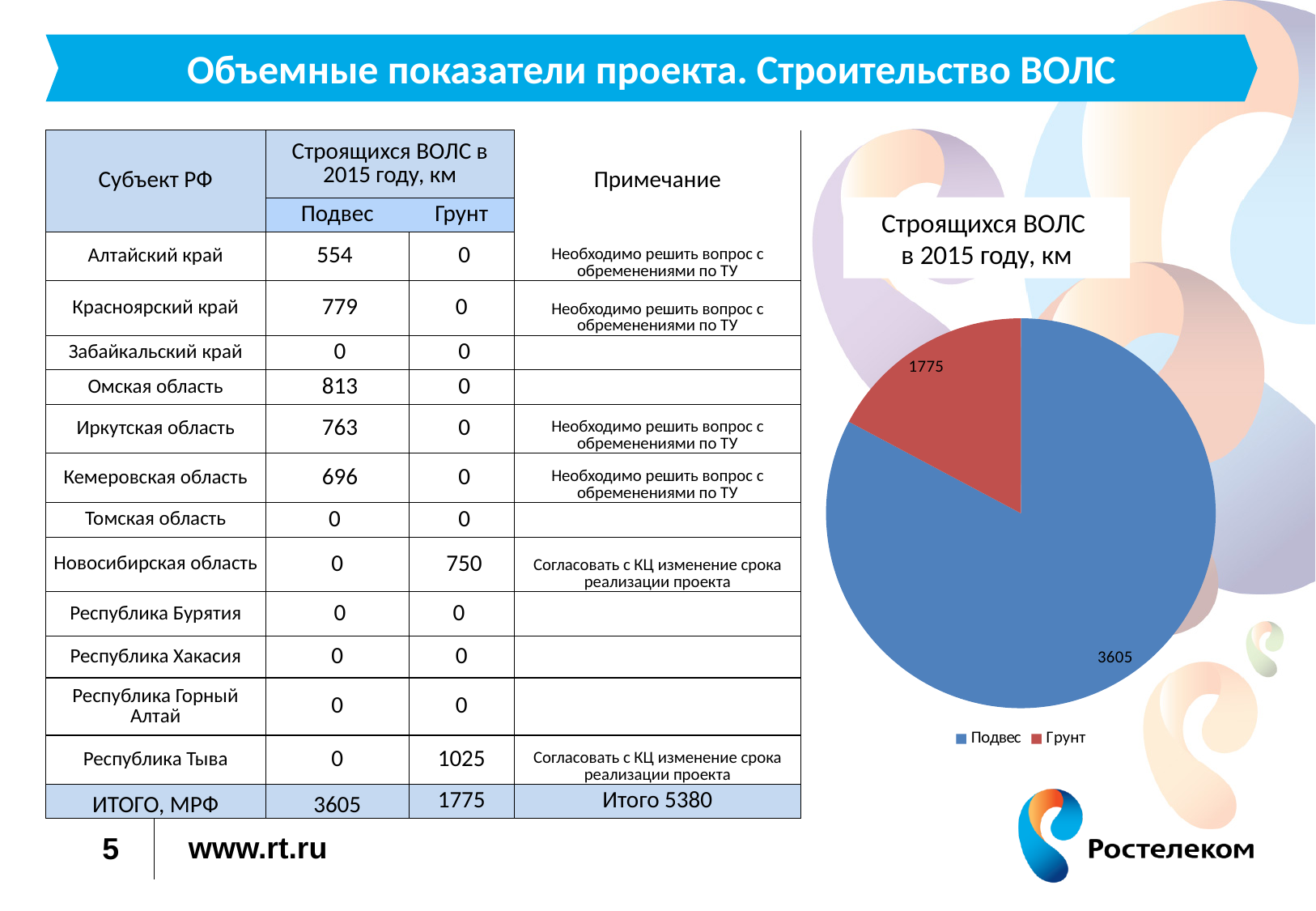
Which slice of the pie chart is the smallest? Грунт Which is larger in the pie chart, Подвес or Грунт? Подвес What type of chart is shown on the slide? pie chart Which slice of the pie chart is the largest? Подвес What is the value for Грунт in the pie chart? 1775 What is the total of the two values shown in the pie chart? 5380 What is the difference between the Подвес and Грунт values in the pie chart? 1830 How many entries does the pie chart legend list? 2 What is the value for Подвес in the pie chart? 3605 What is the title of the pie chart? Строящихся ВОЛС в 2015 году, км How many slices does the pie chart have? 2